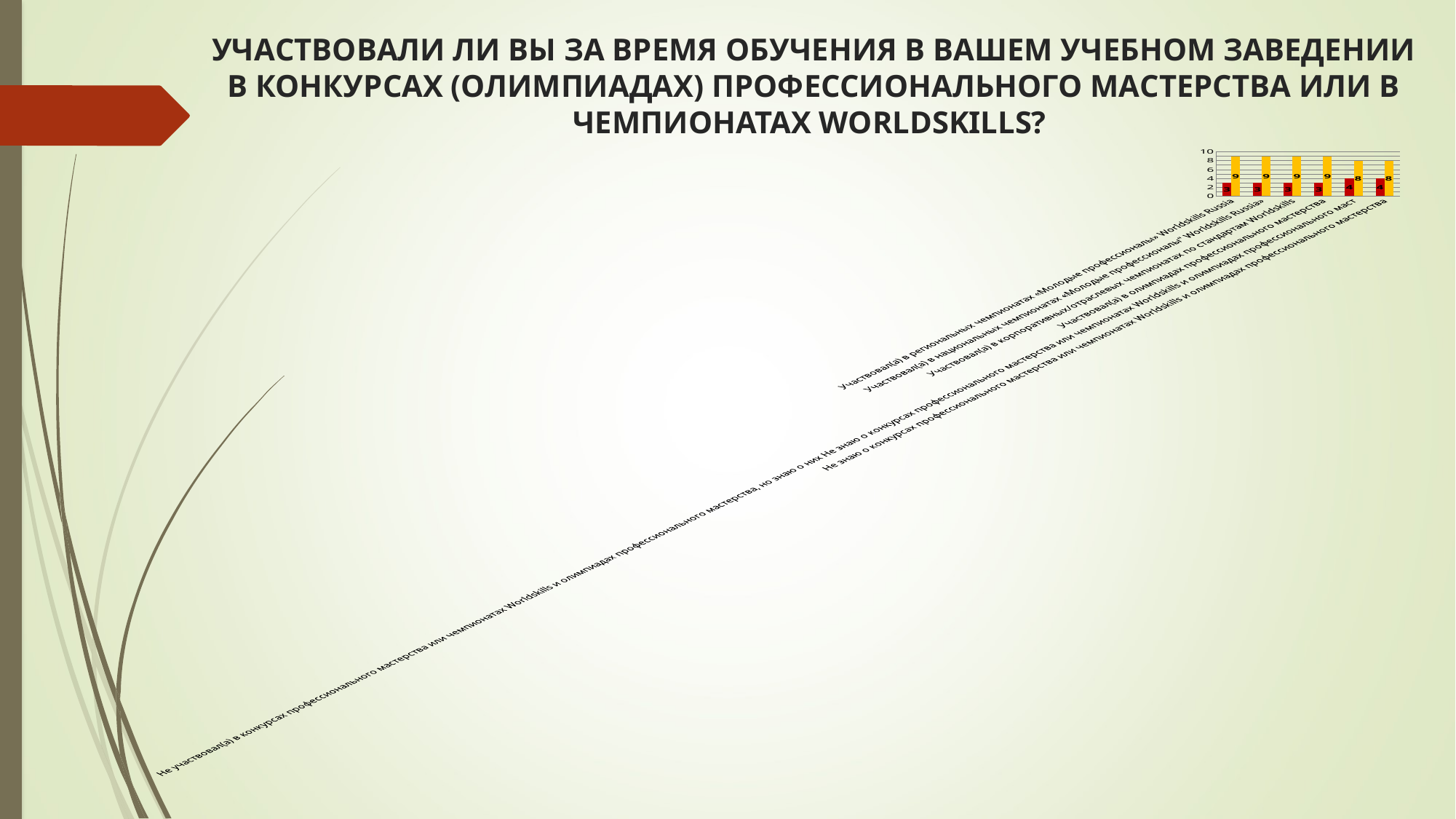
Which is larger, the yellow bar for "Участвовал(а) в олимпиадах профессионального мастерства" or the yellow bar for "Не знаю о конкурсах профессионального мастерства или чемпионатах Worldskills и олимпиадах профессионального мастерства"? Участвовал(а) в олимпиадах профессионального мастерства What is the value of the yellow bar for "Не знаю о конкурсах профессионального мастерства или чемпионатах Worldskills и олимпиадах профессионального мастерства"? 8 What is the value of the yellow bar for "Участвовал(а) в корпоративных/отраслевых чемпионатах по стандартам Worldskills"? 9 Which bar is taller for "Не знаю о конкурсах профессионального мастерства или чемпионатах Worldskills и олимпиадах профессионального мастерства", the red bar or the yellow bar? the yellow bar What is the value of the yellow bar for "Участвовал(а) в олимпиадах профессионального мастерства"? 9 How many categories are shown on the x axis of the chart? 6 What kind of chart is shown on the slide? bar chart What is the value of the yellow bar for "Участвовал(а) в региональных чемпионатах «Молодые профессионалы» Worldskills Russia"? 9 Is the value of the yellow bar for "Участвовал(а) в региональных чемпионатах «Молодые профессионалы» Worldskills Russia" greater or less than 6? greater Is the value of the red bar for "Участвовал(а) в национальных чемпионатах «Молодые профессионалы» Worldskills Russia" greater or less than 6? less What is the highest value shown on the y axis of the chart? 10 What two colours are used for the bars in the chart? red and yellow